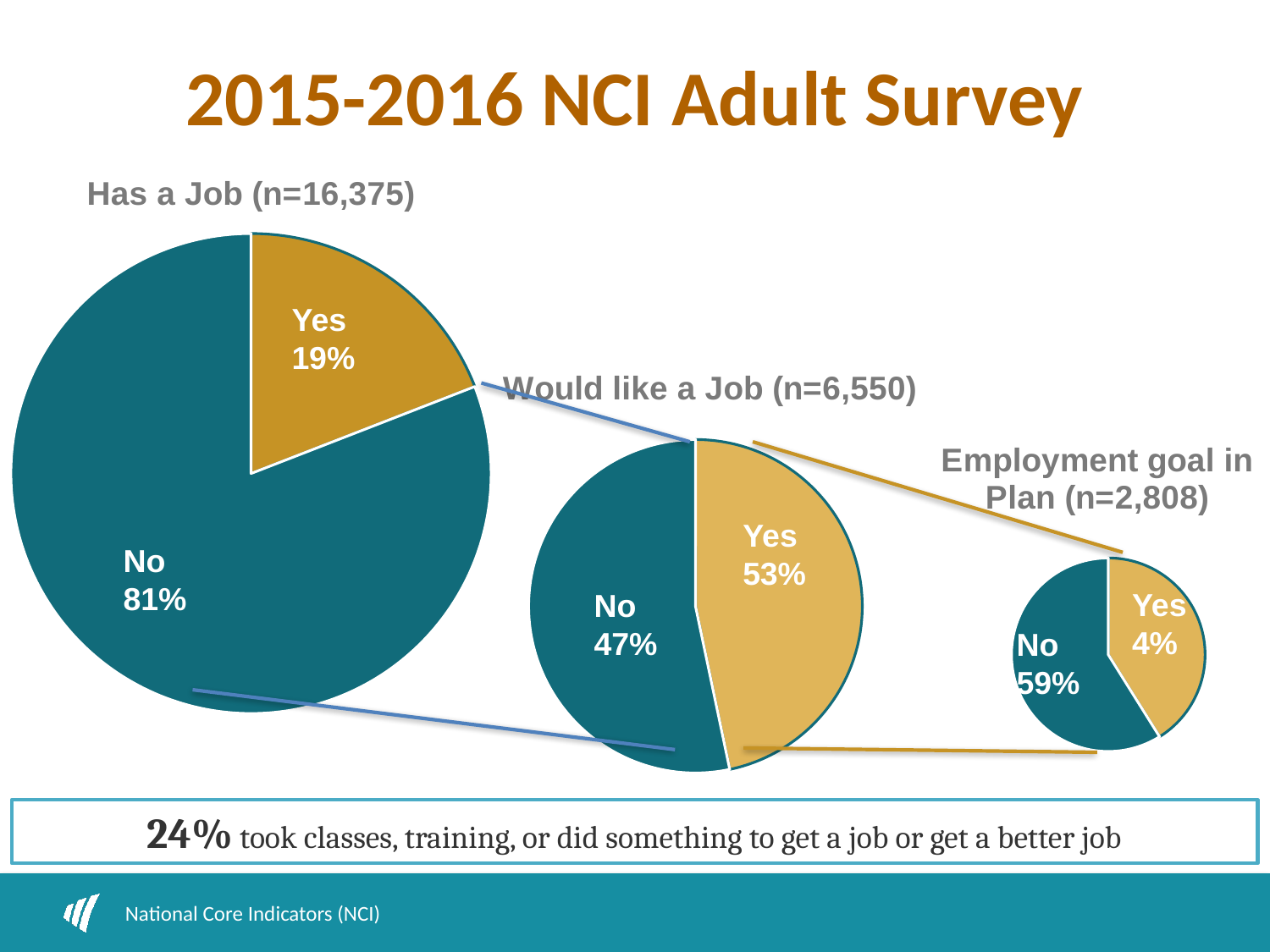
In the 'Would like a Job' pie chart, what percentage answered Yes? 53% What kind of chart is used for 'Has a Job'? Pie chart In the 'Would like a Job' pie chart, what percentage answered No? 47% In the 'Has a Job' pie chart, which slice is larger, Yes or No? No What is the sample size (n) shown in the title of the 'Would like a Job' chart? 6,550 In the 'Would like a Job' pie chart, which slice is larger, Yes or No? Yes In the 'Employment goal in Plan' pie chart, what percentage is labelled No? 59% In the 'Has a Job' pie chart, what percentage answered Yes? 19% In the 'Would like a Job' pie chart, what is the difference between the Yes and No percentages? 6% In the 'Has a Job' pie chart, what is the difference between the No and Yes percentages? 62% In the 'Has a Job' pie chart, what percentage answered No? 81%